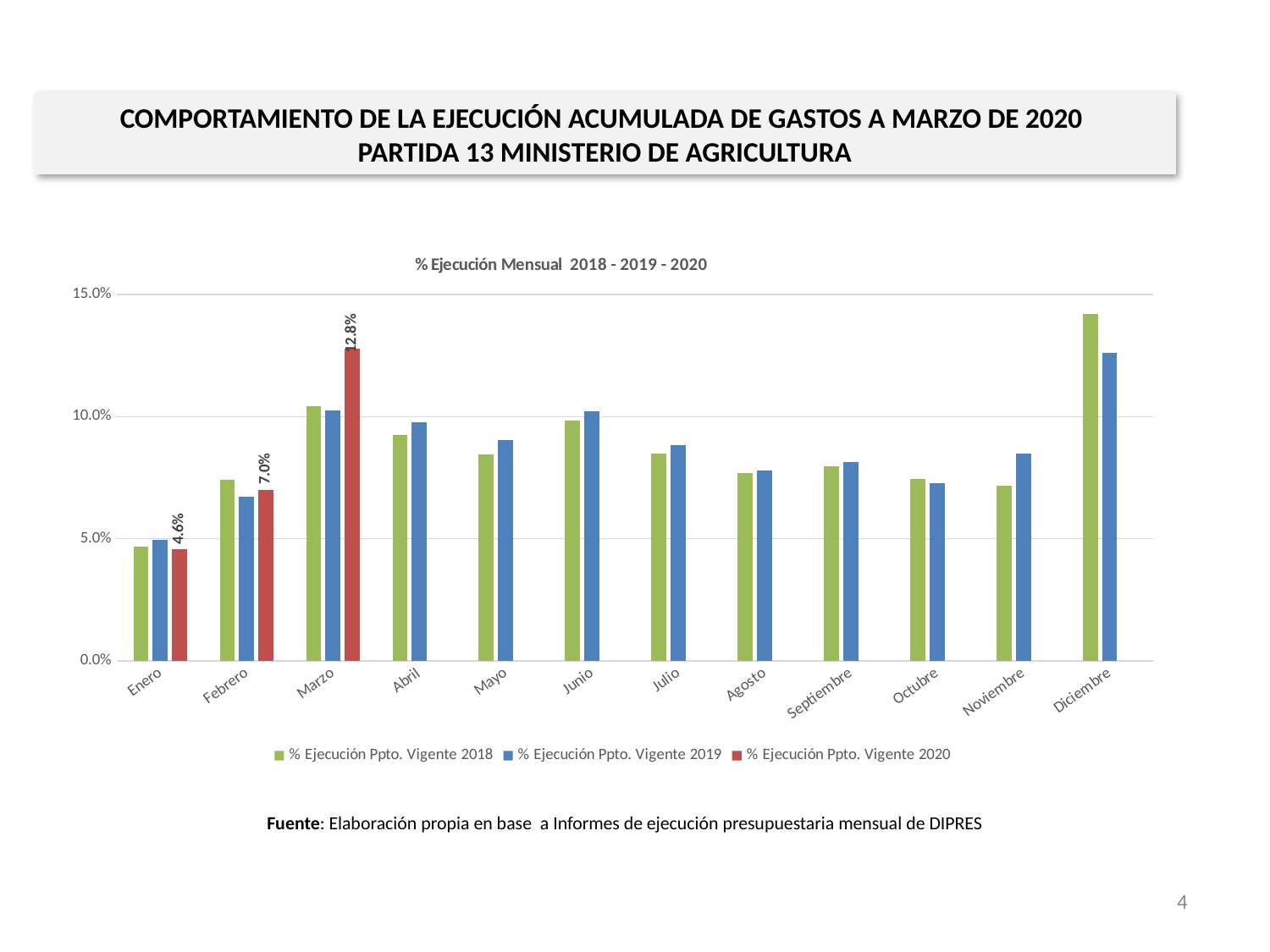
For Marzo, which series has the larger value: % Ejecución Ppto. Vigente 2019 or % Ejecución Ppto. Vigente 2020? % Ejecución Ppto. Vigente 2020 Is the value for Diciembre in the % Ejecución Ppto. Vigente 2018 series greater or less than 10.0%? greater What is the value for Enero in the % Ejecución Ppto. Vigente 2020 series? 4.6% Do the values in the % Ejecución Ppto. Vigente 2020 series rise or fall from Enero to Marzo? Rise What is the value for Febrero in the % Ejecución Ppto. Vigente 2020 series? 7.0% Which month has the highest value in the % Ejecución Ppto. Vigente 2020 series? Marzo Which month has the lowest value in the % Ejecución Ppto. Vigente 2020 series? Enero What kind of chart is shown on the slide? Bar chart How many series does the legend list? 3 What is the difference between the Marzo and Enero values in the % Ejecución Ppto. Vigente 2020 series? 8.2% What is the value for Marzo in the % Ejecución Ppto. Vigente 2020 series? 12.8% How many months are shown on the x axis? 12